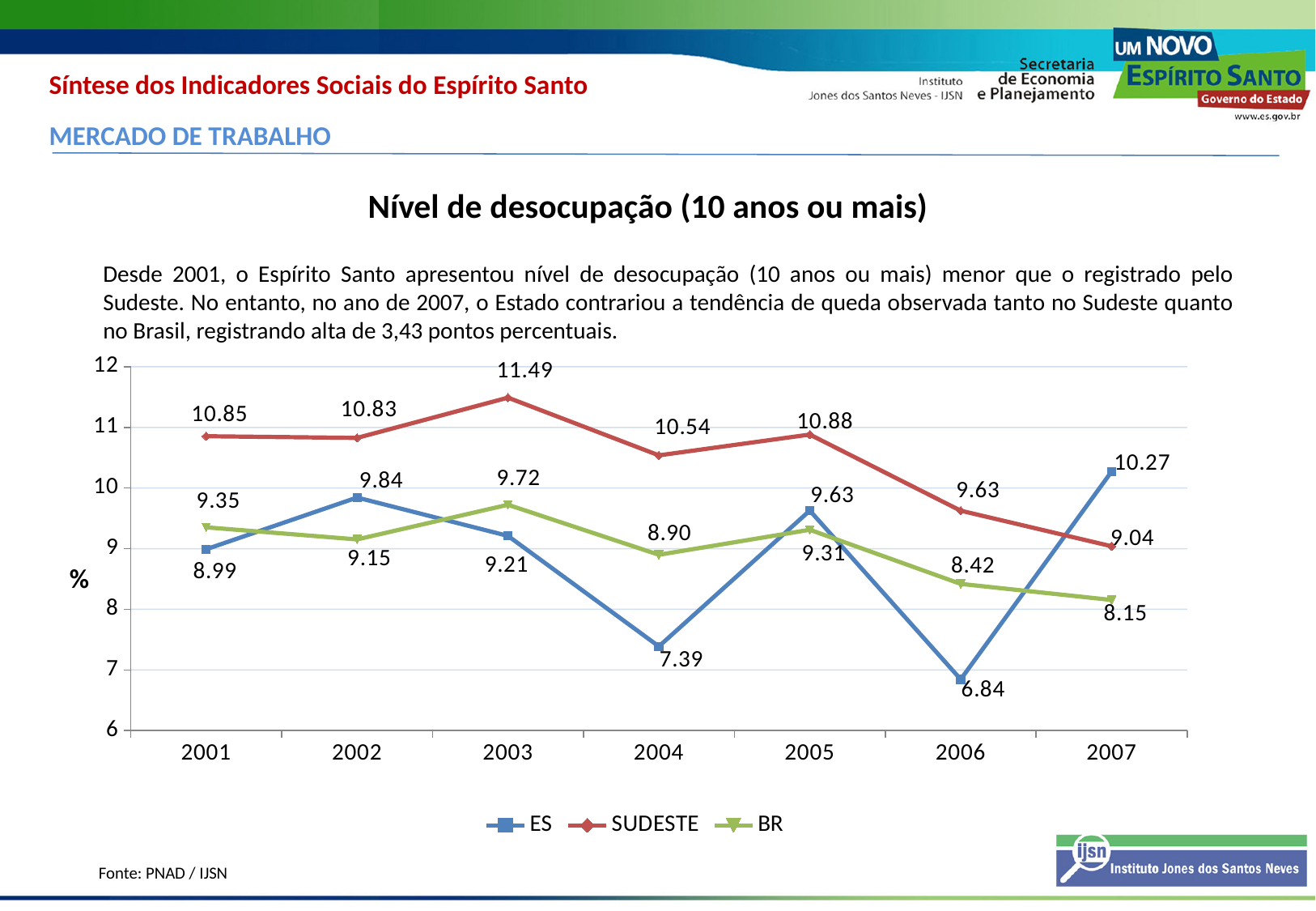
Does the BR series rise or fall from 2005 to 2007? fall In which year does the ES series reach its lowest value? 2006 What type of chart is shown on the slide? line chart How many years are plotted along the x axis? 7 What is the value for ES in 2007? 10.27 What is the value for BR in 2006? 8.42 What is the difference between the SUDESTE and ES values in 2004? 3.15 In which year does the SUDESTE series reach its highest value? 2003 What is the title of the chart? Nível de desocupação (10 anos ou mais) How many series does the legend list? 3 Which is larger in 2007, the value for ES or the value for SUDESTE? ES What is the value for SUDESTE in 2003? 11.49